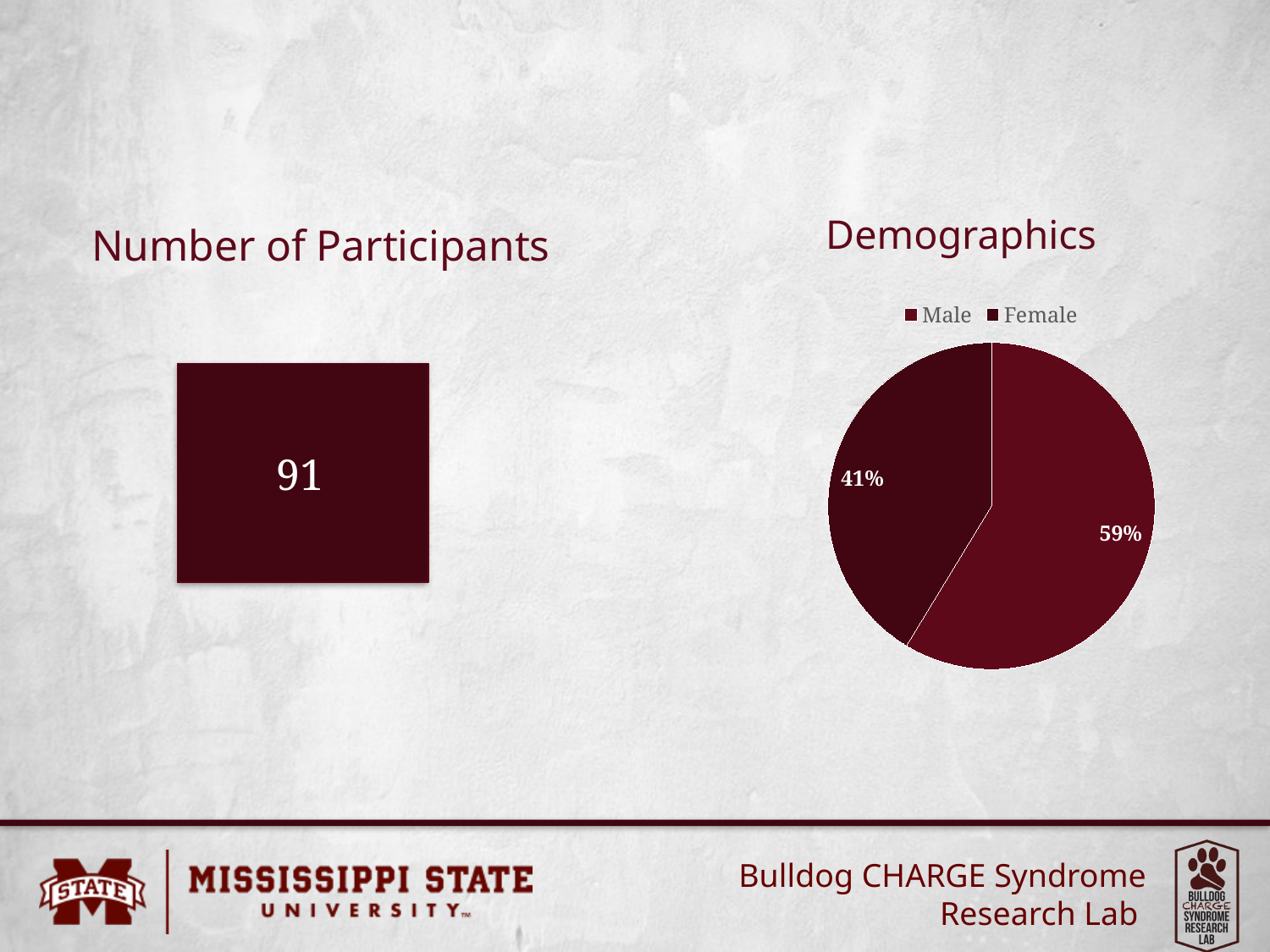
What kind of chart is the Demographics chart? pie chart In the Demographics pie chart, what is the difference in percentage points between the Male and Female shares? 18 How many entries does the legend of the Demographics pie chart list? 2 In the Demographics pie chart, what share is Female? 41% What is the title of the pie chart on the slide? Demographics In the Demographics pie chart, which category has the smallest slice? Female In the Demographics pie chart, is the Female share greater or less than 50%? less In the Demographics pie chart, what share is Male? 59% In the Demographics pie chart, is the Male share larger or smaller than the Female share? larger How many slices does the Demographics pie chart have? 2 What are the two legend entries of the Demographics pie chart? Male and Female In the Demographics pie chart, which category has the largest slice? Male